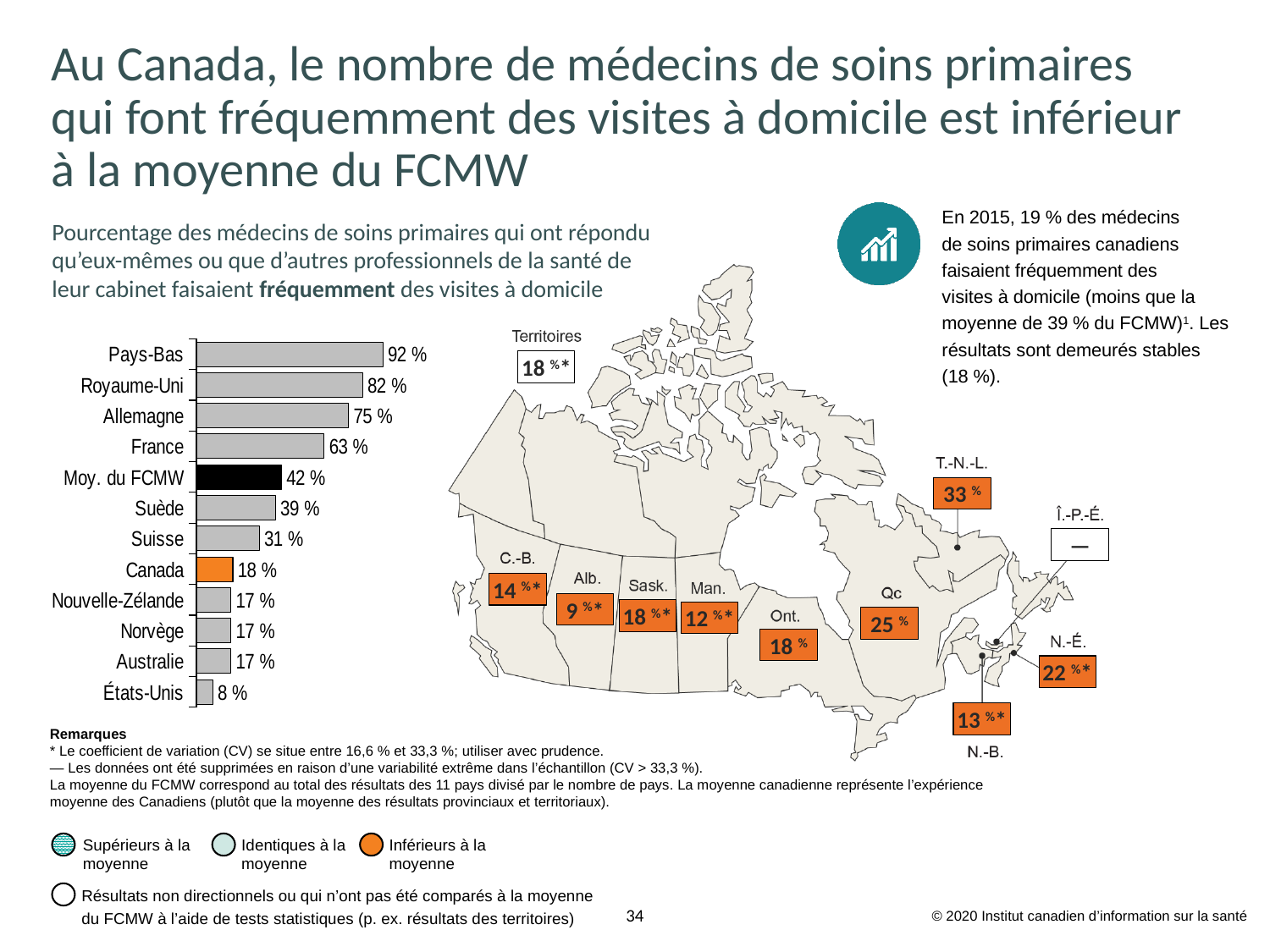
What type of chart is used to show the percentages by country? Bar chart How many categories are shown in the bar chart? 12 Which country has the lowest value in the bar chart? États-Unis Which country has the highest value in the bar chart? Pays-Bas What is the value shown for Pays-Bas in the bar chart? 92 % On the map, what value is shown for Qc (Quebec)? 25 % What is the value shown for Canada in the bar chart? 18 % What is the difference between the values for Royaume-Uni and France in the bar chart? 19 % Which has a larger value in the bar chart, Suède or Suisse? Suède What is the difference between the values for Moy. du FCMW and Canada in the bar chart? 24 % In the bar chart, which bar is coloured orange? Canada What is the value shown for Moy. du FCMW in the bar chart? 42 %